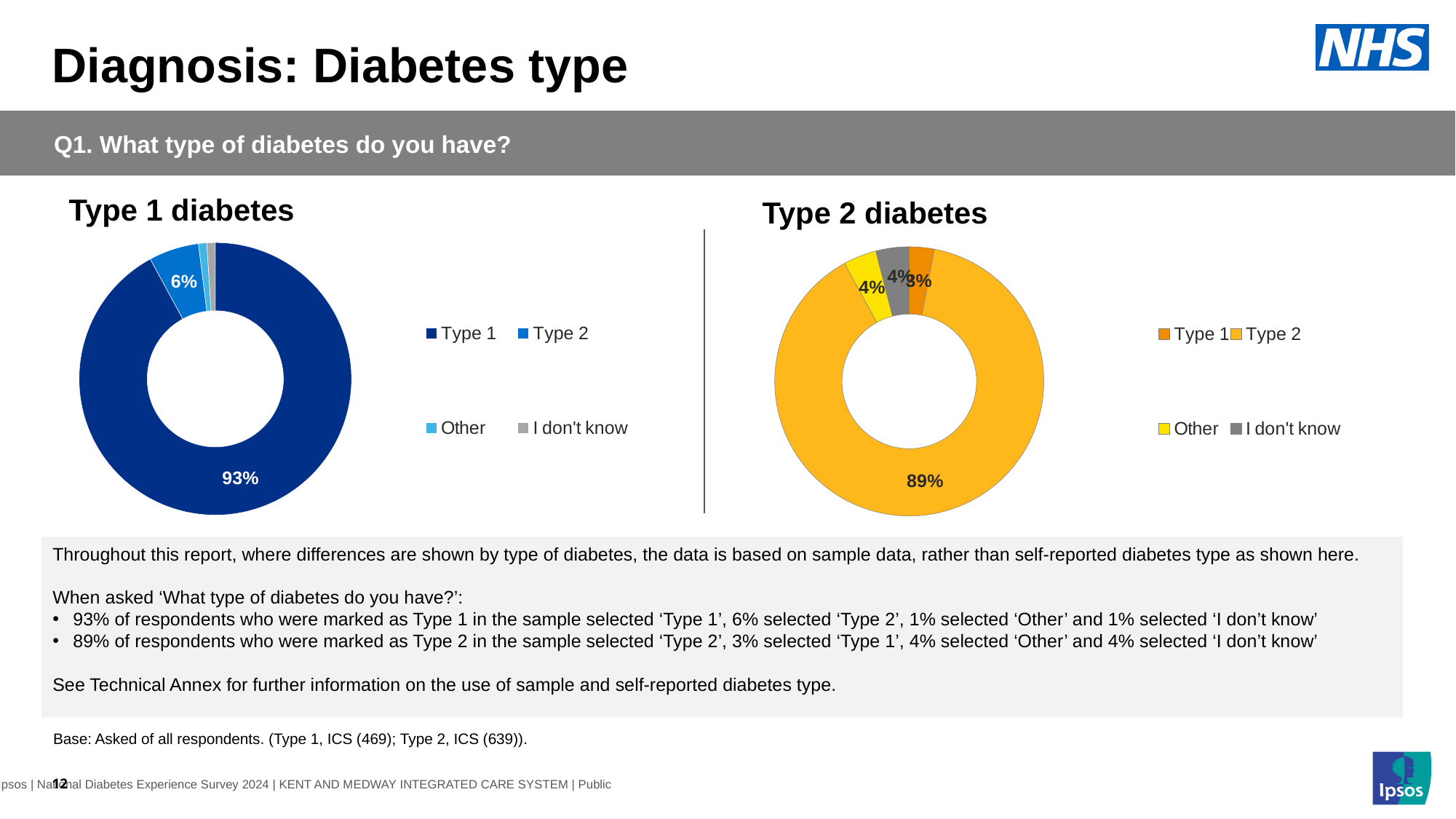
What kind of chart is used for the Type 1 diabetes data? Doughnut (pie) chart How many categories does the legend of the Type 2 diabetes chart list? 4 In the Type 2 diabetes chart, what percentage of respondents selected 'Type 1'? 3% In the Type 1 diabetes chart, what percentage of respondents selected 'Type 2'? 6% In the Type 1 diabetes chart, which category has the largest share? Type 1 Which is larger: the 'Type 1' share in the Type 1 diabetes chart or the 'Type 2' share in the Type 2 diabetes chart? The 'Type 1' share in the Type 1 diabetes chart (93%) What is the title of the chart on the left of the slide? Type 1 diabetes In the Type 2 diabetes chart, which category has the largest share? Type 2 In the Type 2 diabetes chart, what percentage of respondents selected 'Type 2'? 89% In the Type 1 diabetes chart, what percentage of respondents selected 'Type 1'? 93% In the Type 2 diabetes chart, what percentage of respondents selected 'Other'? 4% In the Type 1 diabetes chart, what is the difference in percentage points between the 'Type 1' and 'Type 2' shares? 87 percentage points